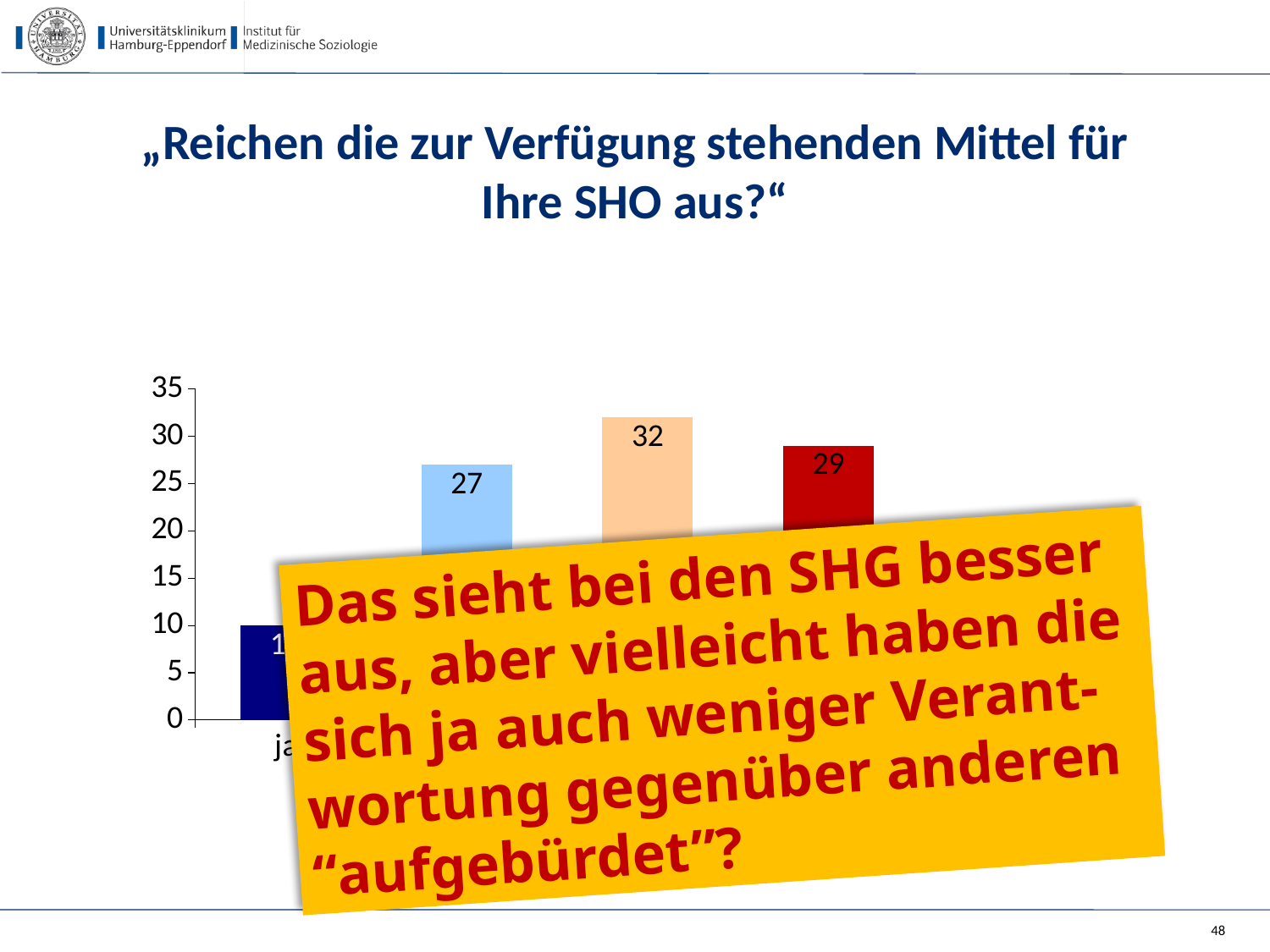
Which bar has the highest value? the third bar from the left (32) Is the value of the first (dark blue) bar greater or less than 15? less What is the difference between the third bar (32) and the fourth bar (29)? 3 What is the title of the slide above the chart? „Reichen die zur Verfügung stehenden Mittel für Ihre SHO aus?“ What is the value of the second bar from the left? 27 What is the value of the fourth bar from the left (the red bar)? 29 What kind of chart is shown on the slide? bar chart Which is larger, the value of the second bar or the value of the fourth bar? the fourth bar (29) What is the value of the third bar from the left? 32 What is the difference between the third bar (32) and the second bar (27)? 5